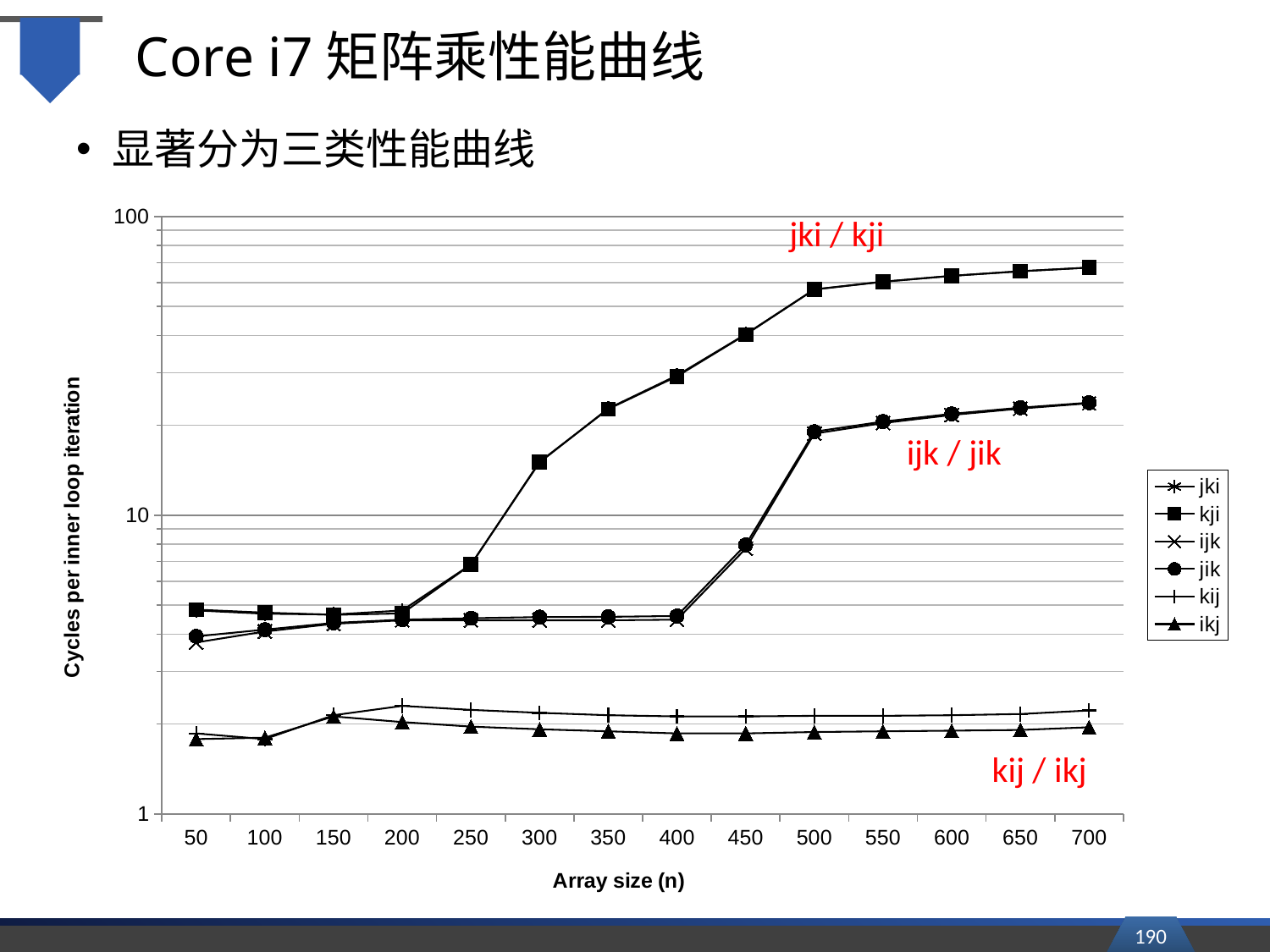
How many array-size values are plotted along the x axis? 14 Is the value for kij at array size 700 greater or less than 10? less What kind of chart is shown on the slide? line chart Is the value for jik at array size 300 greater or less than 10? less How many series does the legend list? 6 At array size 700, which is larger, the value for kji or the value for jik? kji Is the value for kji at array size 300 greater or less than 10? greater Does the kji curve rise or fall as the array size increases from 50 to 700? rise Which pair of curves is highest at array size 700? jki / kji What is the title of the y axis? Cycles per inner loop iteration